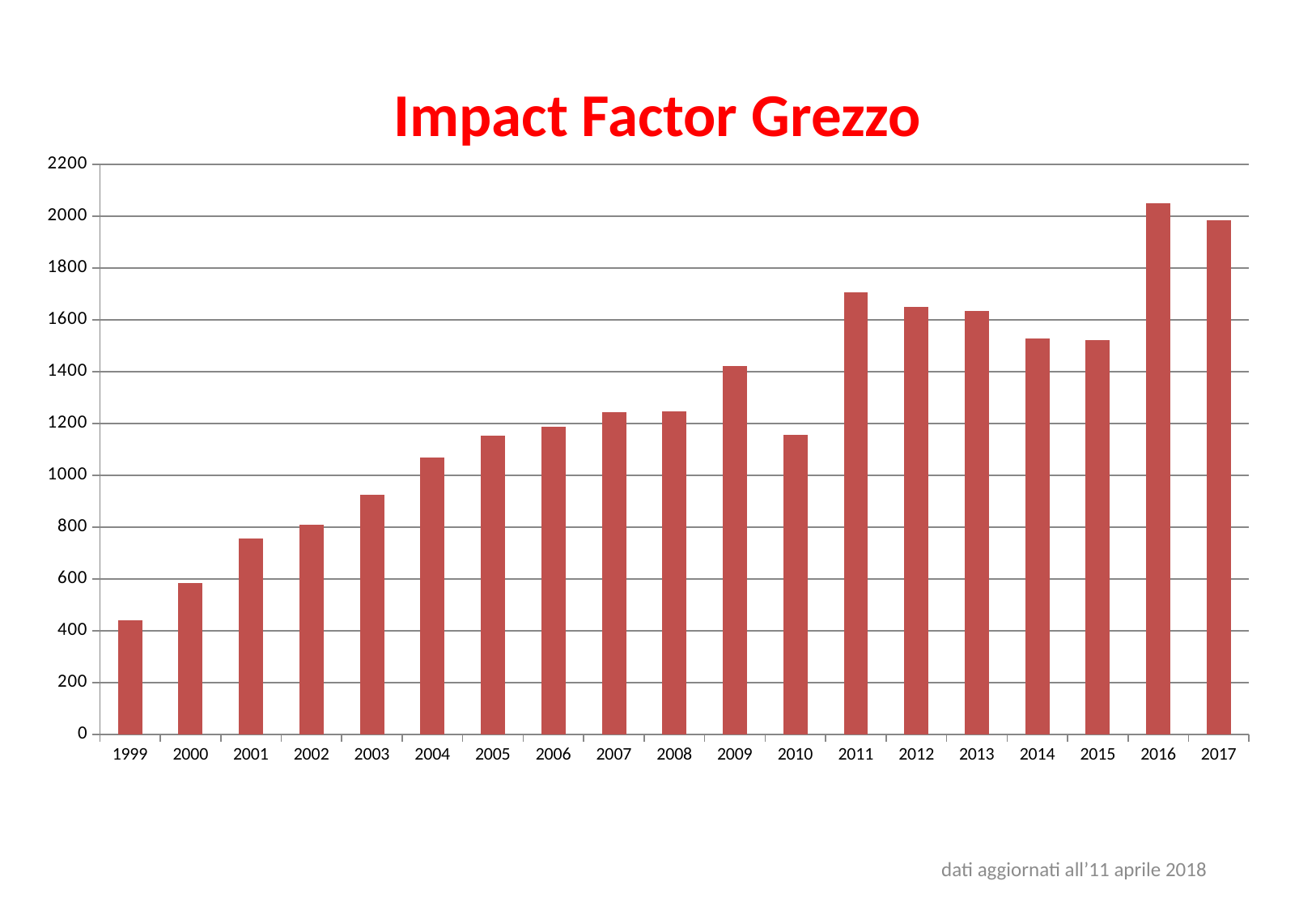
What is the title of the chart? Impact Factor Grezzo Is the value for 2003 greater or less than 1000? less Which is larger, the value for 2009 or the value for 2010? 2009 Which year has the lowest value in the chart? 1999 How many years are shown on the x axis of the chart? 19 Is the value for 2010 greater or less than 1200? less Is the value for 2016 greater or less than 2000? greater Overall, do the values rise or fall from 1999 to 2017? rise What kind of chart is shown on the slide? bar chart Which year has the highest value in the chart? 2016